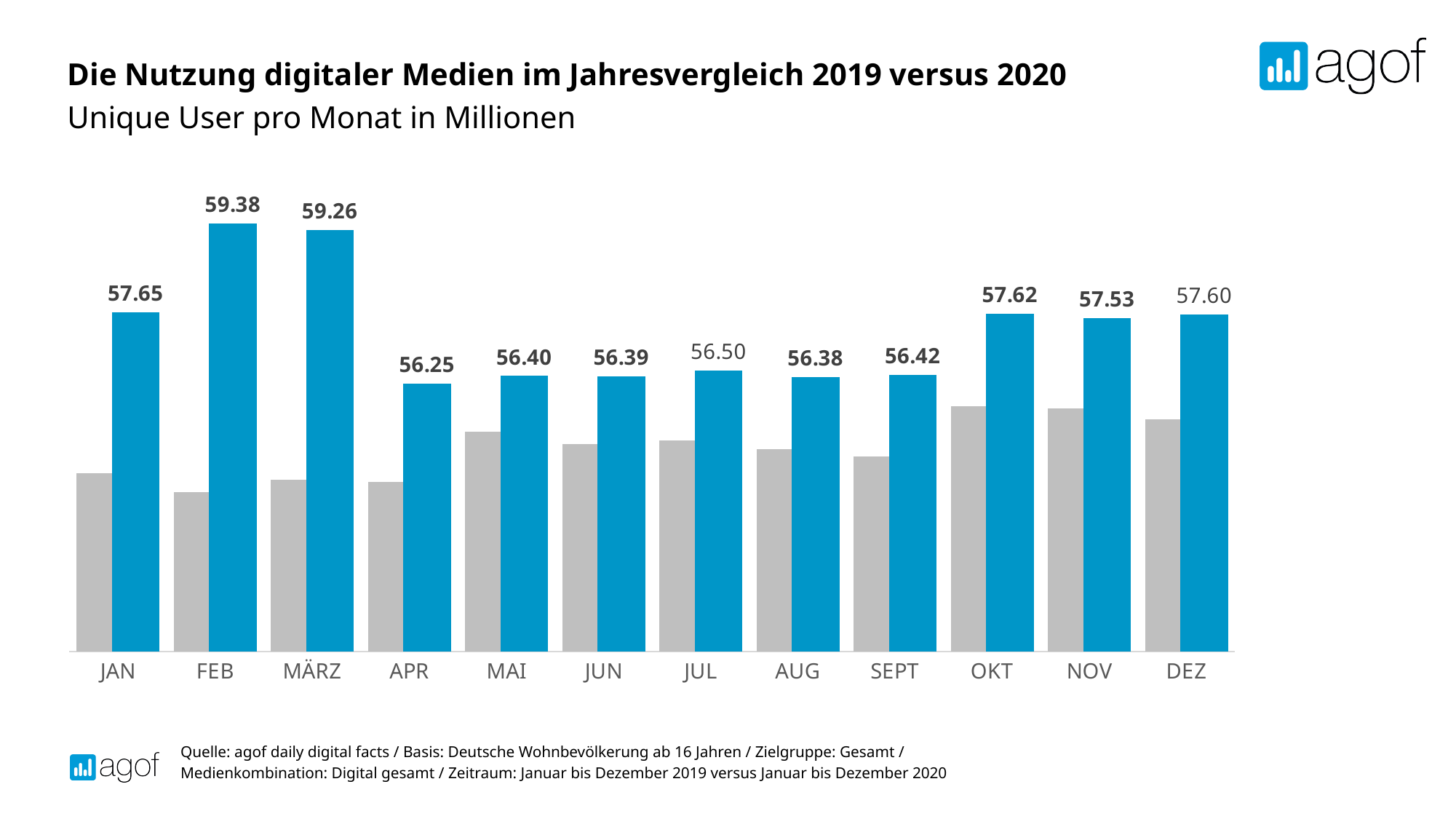
Which has the larger labelled value, JUL or AUG? JUL How many months are shown on the x axis? 12 Do the labelled values rise or fall from FEB to APR? fall What is the labelled value for DEZ? 57.60 What is the difference between the labelled values for FEB and MÄRZ? 0.12 What type of chart is shown on the slide? bar chart What is the labelled value for APR? 56.25 Which month has the lowest labelled value? APR What is the difference between the labelled values for JAN and DEZ? 0.05 What is the labelled value for FEB? 59.38 Which month has the highest labelled value? FEB What is the title of the chart? Die Nutzung digitaler Medien im Jahresvergleich 2019 versus 2020